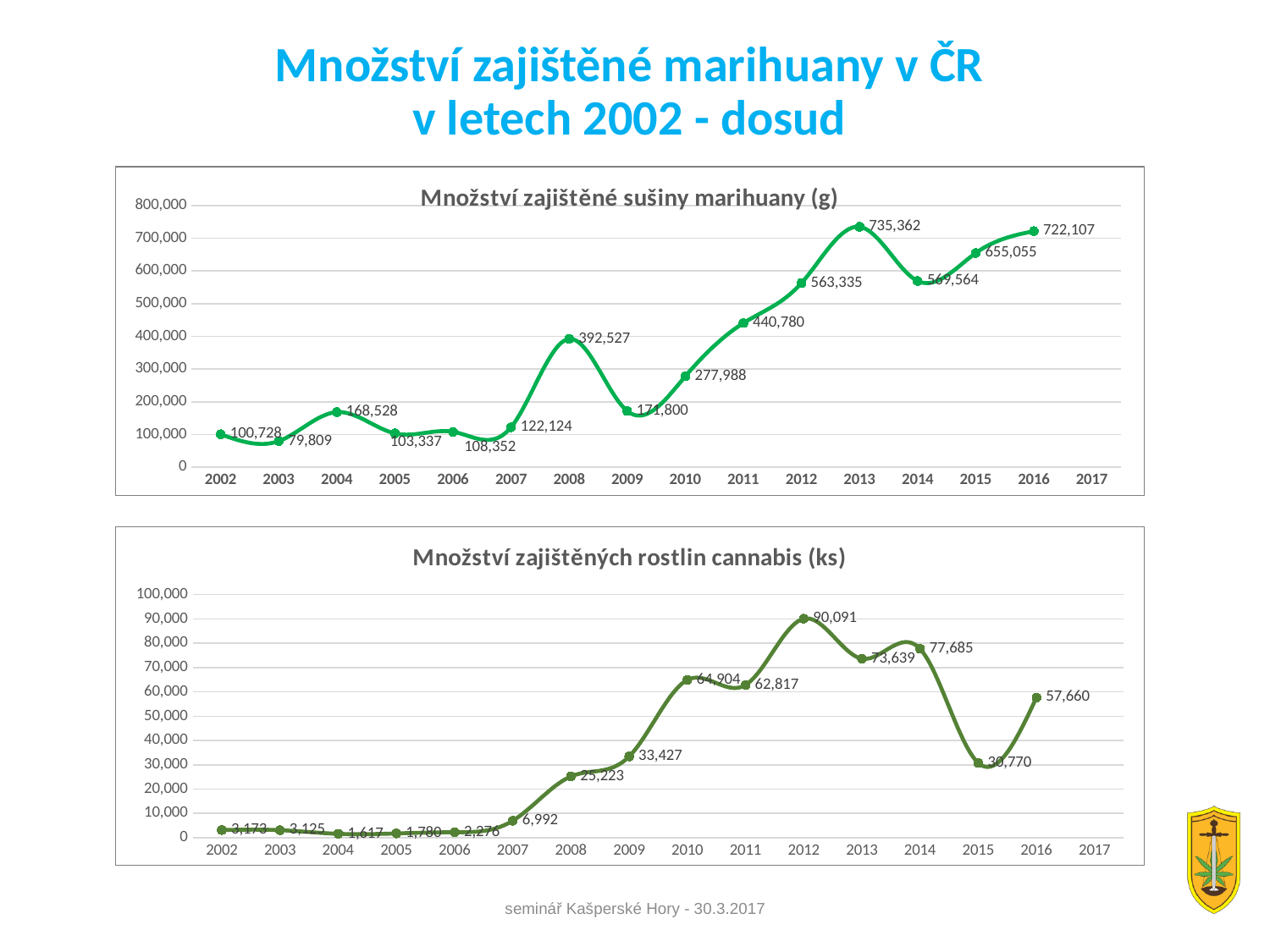
What is the title of the bottom chart on the slide? Množství zajištěných rostlin cannabis (ks) In the bottom chart (Množství zajištěných rostlin cannabis (ks)), is the value for 2009 greater or less than 30,000? greater In the bottom chart (Množství zajištěných rostlin cannabis (ks)), what is the value for 2012? 90,091 In the top chart (Množství zajištěné sušiny marihuany (g)), what is the difference between the values for 2016 and 2015? 67,052 In the top chart (Množství zajištěné sušiny marihuany (g)), which year has the lowest value? 2003 In the bottom chart (Množství zajištěných rostlin cannabis (ks)), which year has the highest value? 2012 What kind of chart is the top chart on the slide? Line chart In the bottom chart (Množství zajištěných rostlin cannabis (ks)), what is the difference between the values for 2014 and 2013? 4,046 In the bottom chart (Množství zajištěných rostlin cannabis (ks)), which year has the larger value, 2010 or 2011? 2010 In the top chart (Množství zajištěné sušiny marihuany (g)), which year has the highest value? 2013 In the top chart (Množství zajištěné sušiny marihuany (g)), what is the value for 2013? 735,362 In the top chart (Množství zajištěné sušiny marihuany (g)), how many years have a plotted data point? 15